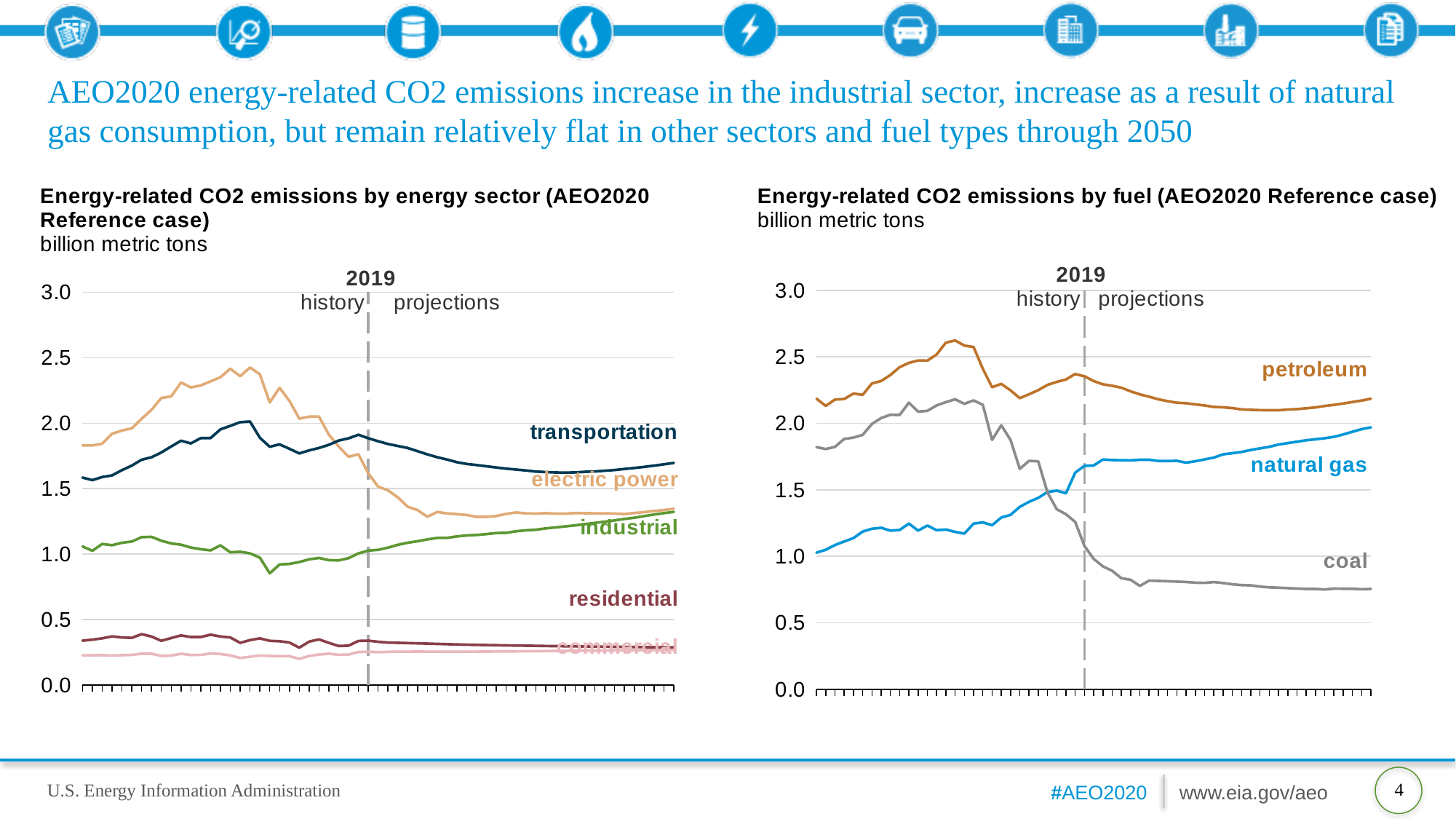
In the 'Energy-related CO2 emissions by energy sector' chart, which sector has the lowest emissions at the end of the projection period? commercial In the 'Energy-related CO2 emissions by energy sector' chart, is the value for transportation at the end of the projection period greater or less than 1.5? greater In the 'Energy-related CO2 emissions by fuel' chart, does the coal series rise or fall over the period shown? fall What year does the dashed vertical line separating history from projections mark in both charts? 2019 What kind of chart is the 'Energy-related CO2 emissions by energy sector' chart on the left? line chart How many sectors are plotted in the 'Energy-related CO2 emissions by energy sector' chart on the left? 5 How many series are plotted in the 'Energy-related CO2 emissions by fuel' chart on the right? 3 In the 'Energy-related CO2 emissions by fuel' chart, is the value for coal at the end of the projection period greater or less than 1.0? less In the 'Energy-related CO2 emissions by fuel' chart, which fuel has the highest emissions at the end of the projection period? petroleum In the 'Energy-related CO2 emissions by fuel' chart, which fuel has the lowest emissions at the end of the projection period? coal In the 'Energy-related CO2 emissions by energy sector' chart, which is larger in 2019, transportation or electric power? transportation In the 'Energy-related CO2 emissions by energy sector' chart, which sector has the highest emissions at the end of the projection period? transportation